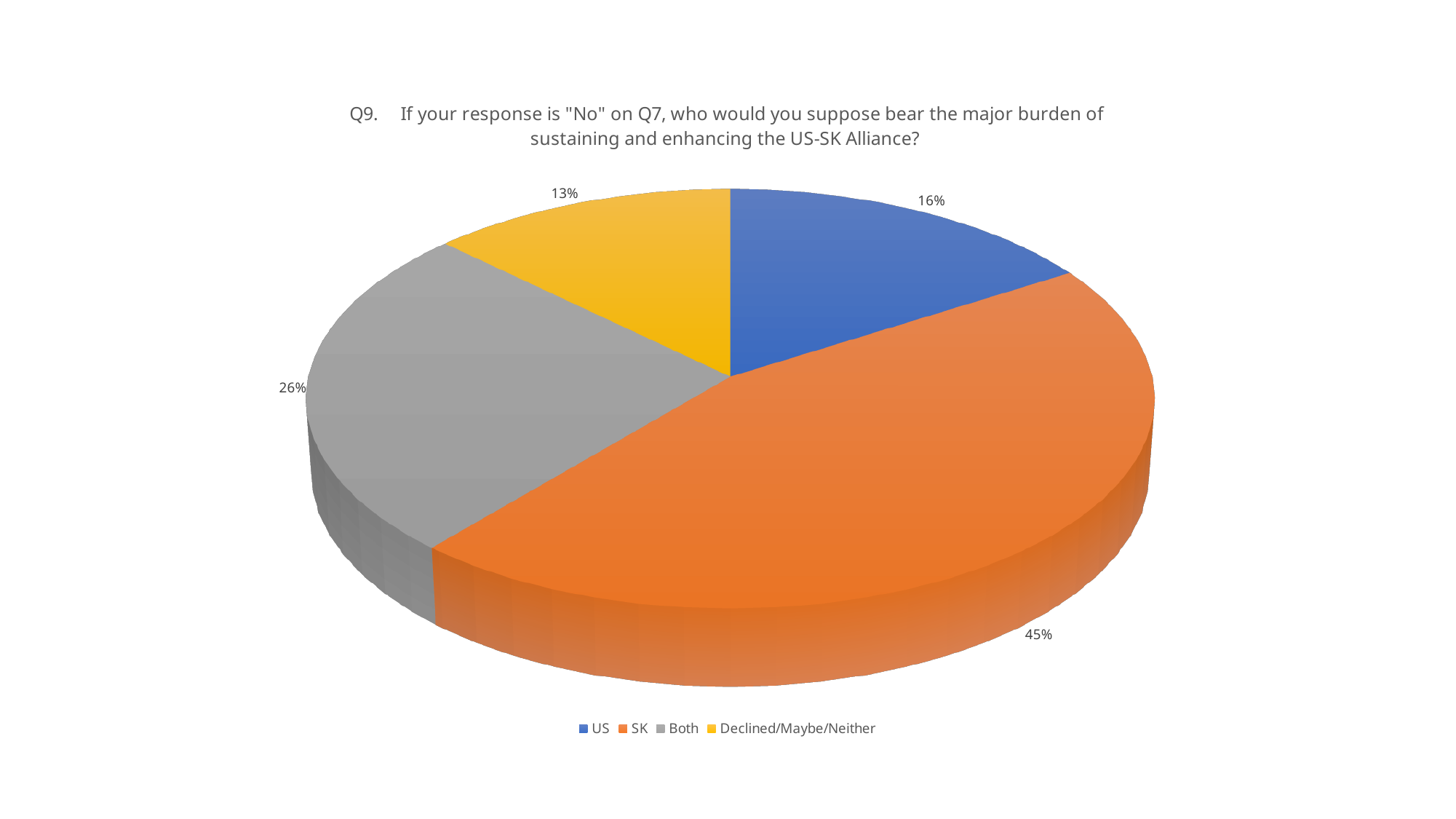
What is the combined share of US and SK? 61% How many categories does the pie chart have? 4 What percentage of responses is for Declined/Maybe/Neither? 13% Which category has the largest share of the pie? SK Which is larger, the share for US or the share for Both? Both What percentage of responses is for Both? 26% What percentage of responses is for SK? 45% Which category has the smallest share of the pie? Declined/Maybe/Neither What percentage of responses is for US? 16% What is the difference in percentage points between SK and Both? 19 What kind of chart is shown on the slide? Pie chart What colour is the slice for SK? Orange